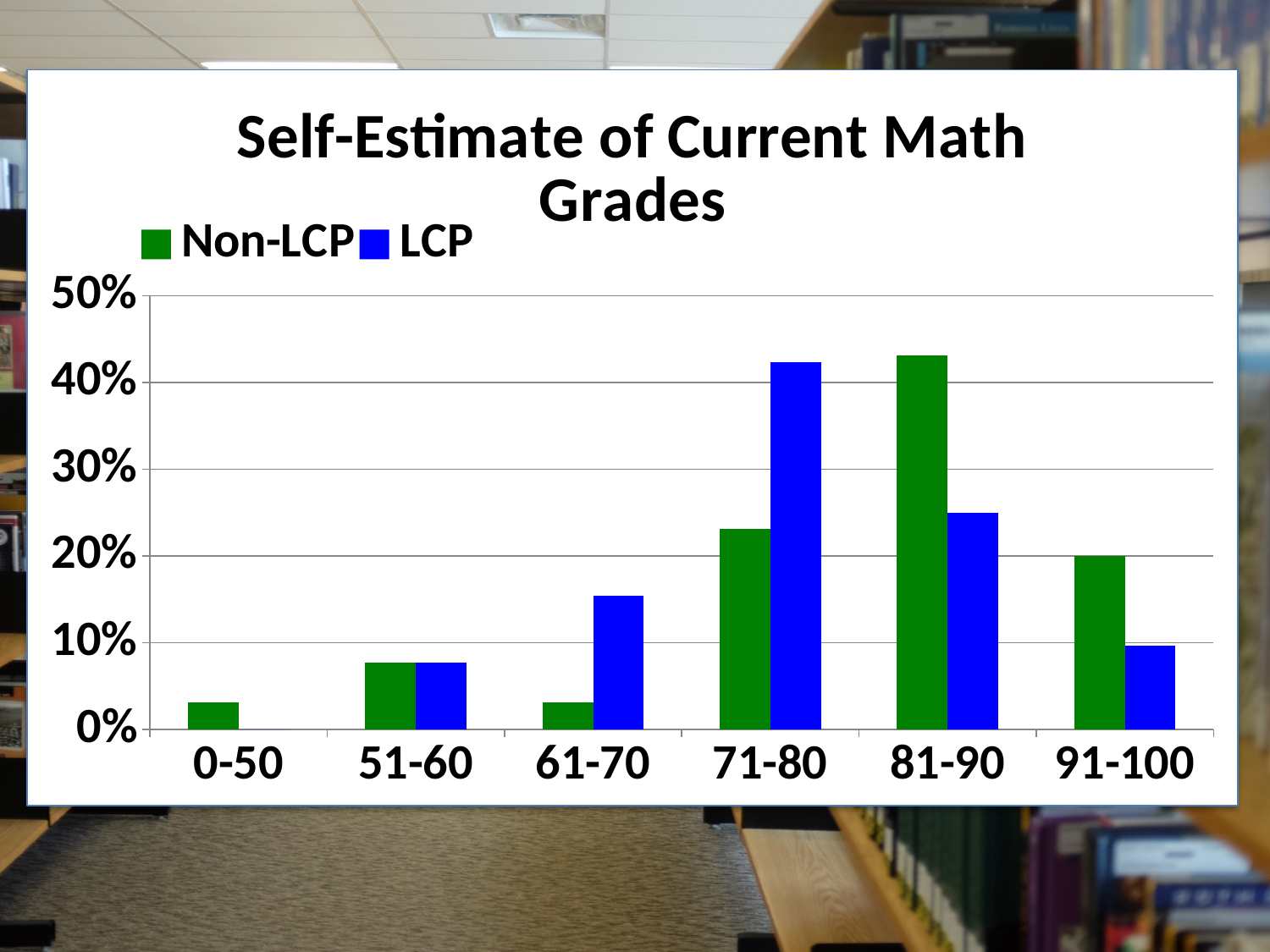
Which grade range has the highest Non-LCP value? 81-90 Is the LCP value for 81-90 greater or less than 30%? less For the 71-80 grade range, which series has the larger value, Non-LCP or LCP? LCP Which grade range has the lowest LCP value? 0-50 What is the title of the chart? Self-Estimate of Current Math Grades Which grade range has the highest LCP value? 71-80 What kind of chart is shown on the slide? bar chart Which colour represents the LCP series? blue How many grade-range categories are shown on the x axis? 6 Is the LCP value for 61-70 greater or less than 10%? greater How many series does the legend list? 2 Is the Non-LCP value for 81-90 greater or less than 40%? greater